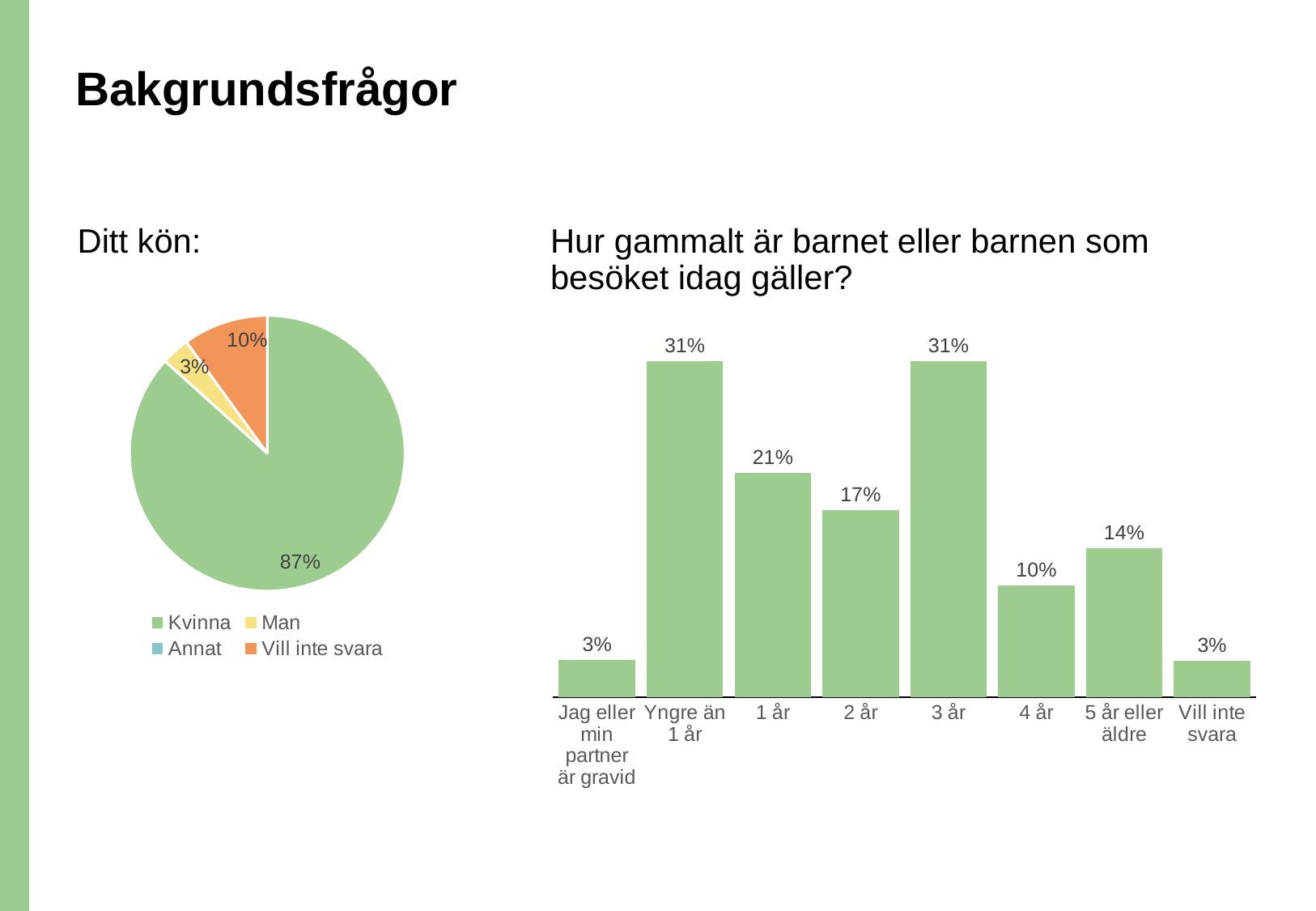
In the bar chart 'Hur gammalt är barnet eller barnen som besöket idag gäller?', what is the value for 2 år? 17% In the bar chart 'Hur gammalt är barnet eller barnen som besöket idag gäller?', what is the value for 4 år? 10% In the pie chart 'Ditt kön:', which category has the largest slice? Kvinna What kind of chart is shown on the right side of the slide? Bar chart In the bar chart 'Hur gammalt är barnet eller barnen som besöket idag gäller?', how many categories are shown on the x axis? 8 In the pie chart 'Ditt kön:', what share is Vill inte svara? 10% In the pie chart 'Ditt kön:', what share is Kvinna? 87% In the bar chart 'Hur gammalt är barnet eller barnen som besöket idag gäller?', which is larger, the value for 1 år or the value for 4 år? 1 år In the bar chart 'Hur gammalt är barnet eller barnen som besöket idag gäller?', what is the difference between the values for 1 år and 2 år? 4% In the pie chart 'Ditt kön:', how many entries does the legend list? 4 In the pie chart 'Ditt kön:', what share is Man? 3% In the bar chart 'Hur gammalt är barnet eller barnen som besöket idag gäller?', what is the value for 5 år eller äldre? 14%